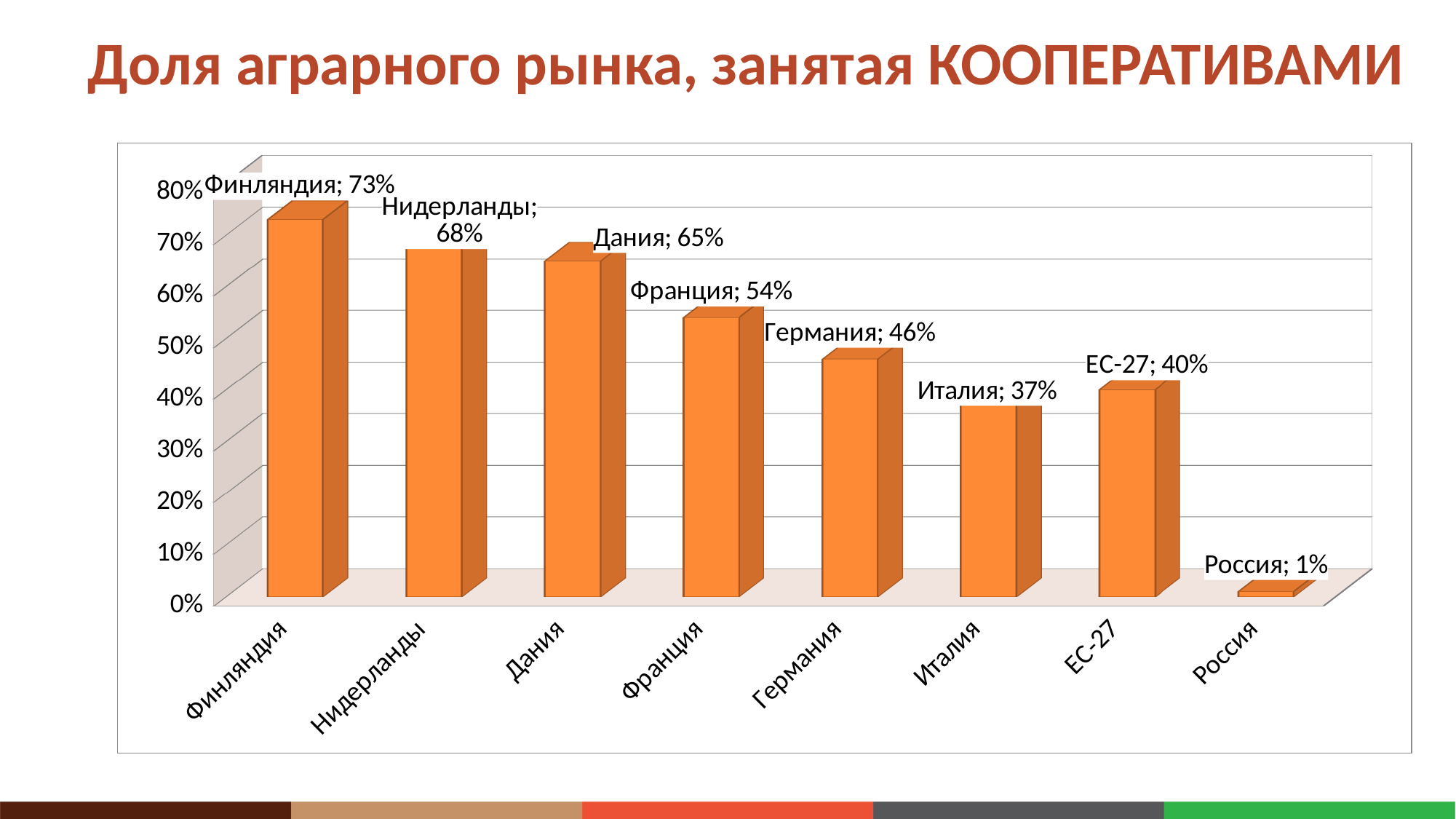
What is the difference between the values for Франция and Италия? 17% Which category has the highest value? Финляндия What is the value for ЕС-27? 40% Is the value for Италия greater or less than 40%? less What is the value for Финляндия? 73% What is the title of the slide? Доля аграрного рынка, занятая КООПЕРАТИВАМИ Which category has the lowest value? Россия What kind of chart is shown on the slide? bar chart What is the difference between the values for Нидерланды and Дания? 3% What is the value for Германия? 46% How many categories are shown on the chart? 8 Which is larger, the value for Германия or the value for ЕС-27? Германия